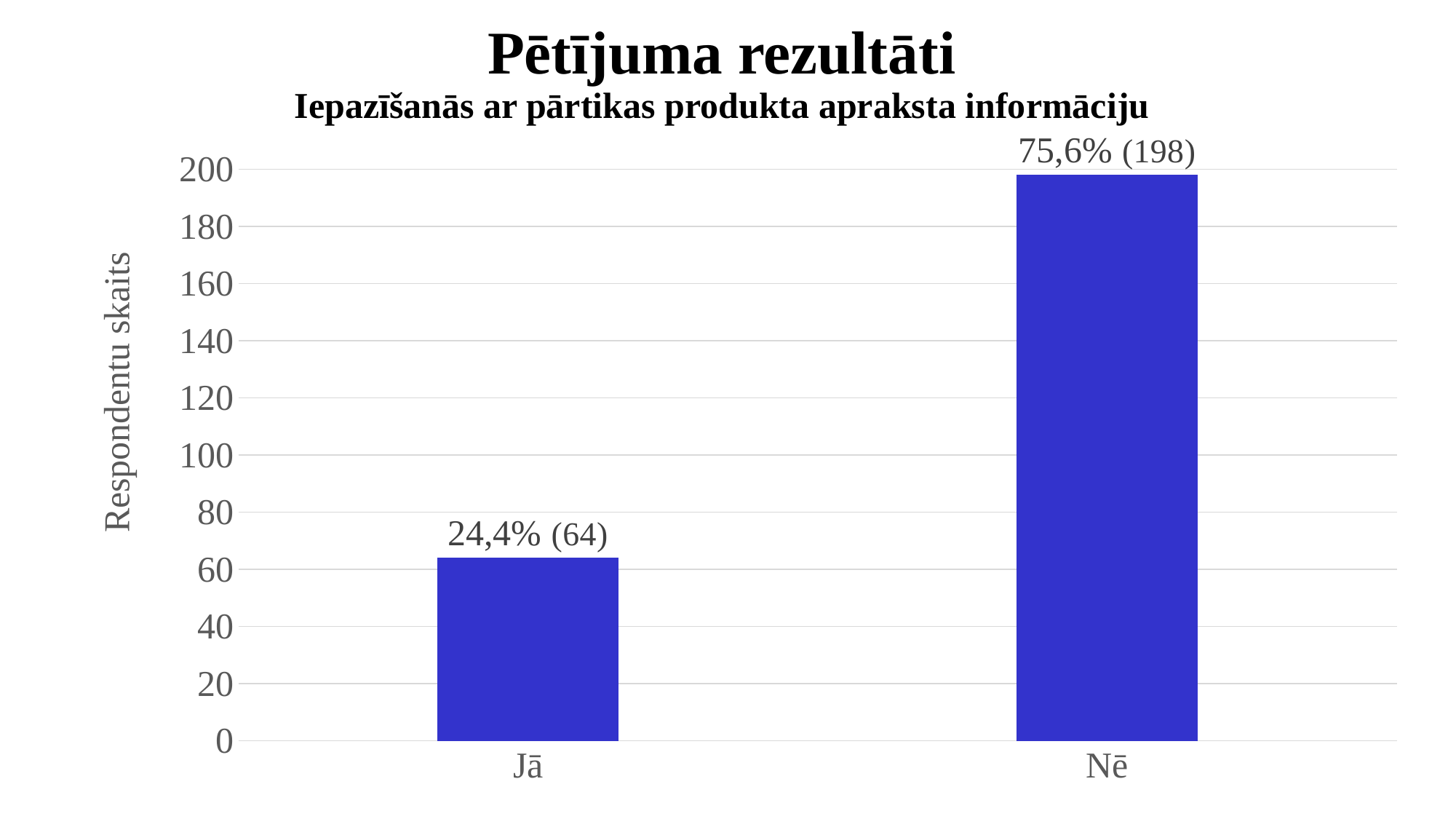
How many categories are shown on the x axis? 2 Which has more respondents, "Jā" or "Nē"? Nē What is the data label shown for the "Jā" bar? 24,4% (64) What is the data label shown for the "Nē" bar? 75,6% (198) Is the value for "Jā" greater or less than 100? less Which category has the highest number of respondents? Nē What is the label of the vertical axis? Respondentu skaits What is the difference in respondent count between "Nē" and "Jā"? 134 What kind of chart is shown on the slide? Bar chart How many respondents answered "Nē"? 198 How many respondents answered "Jā"? 64 Which category has the lowest number of respondents? Jā